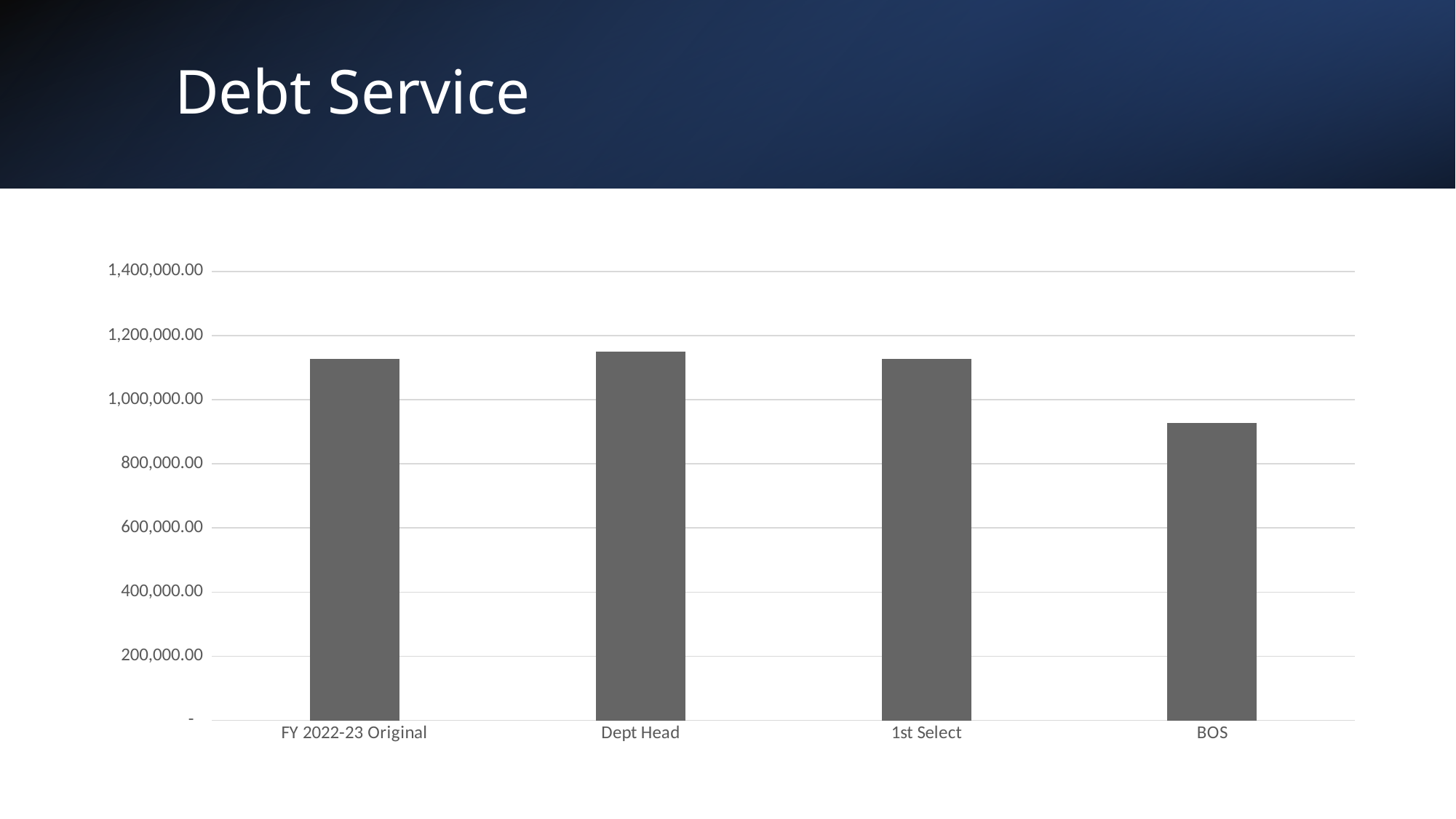
What is the title of the slide containing the chart? Debt Service Which is larger, the value for Dept Head or the value for BOS? Dept Head Is the value for 1st Select greater or less than 1,000,000.00? greater How many categories are plotted on the chart? 4 Is the value for Dept Head greater or less than 1,000,000.00? greater Is the value for BOS greater or less than 1,000,000.00? less Which is larger, the value for 1st Select or the value for BOS? 1st Select What kind of chart is shown on the slide? bar chart Which category has the lowest value on the chart? BOS What is the highest value shown on the vertical axis of the chart? 1,400,000.00